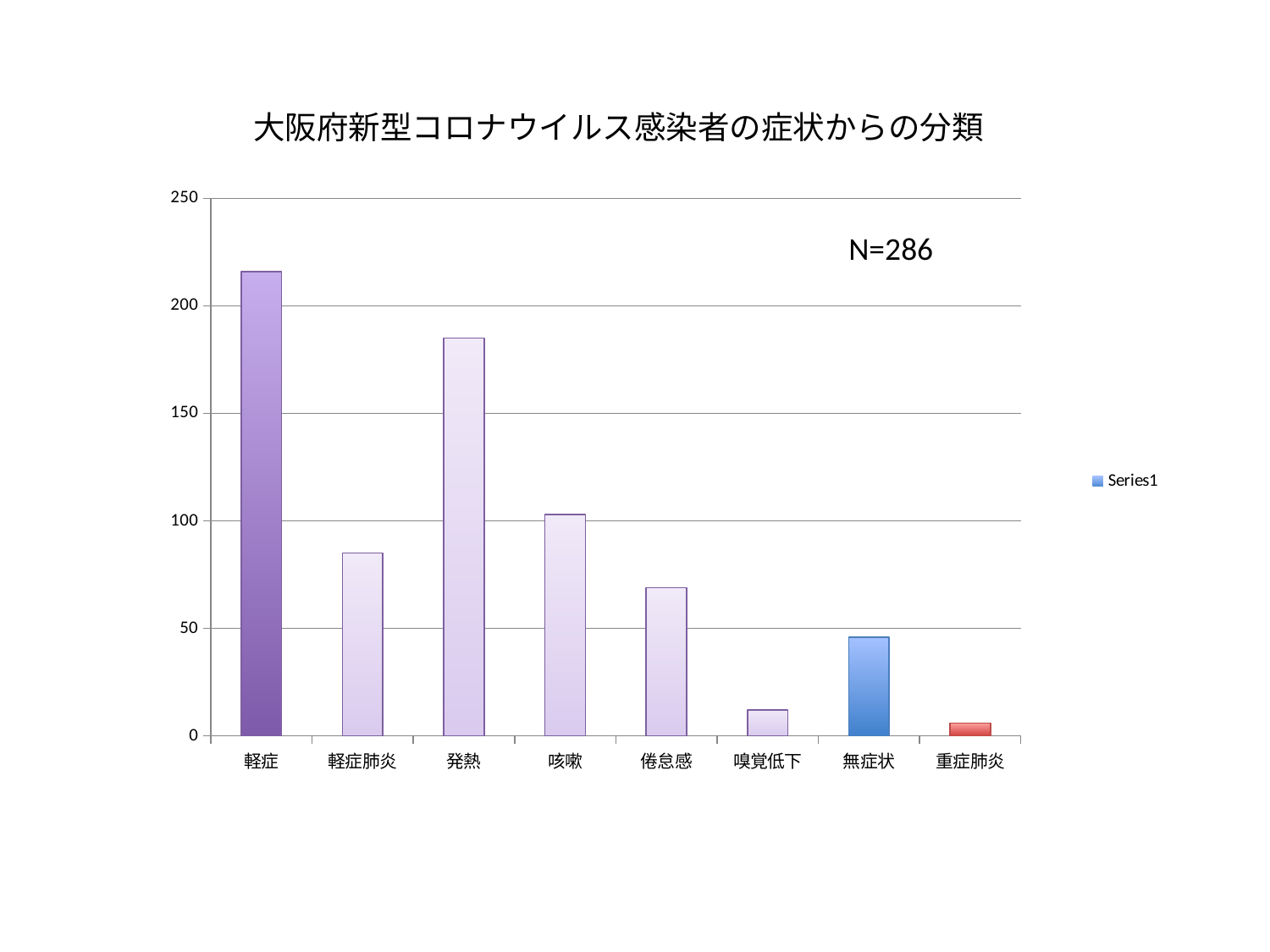
What is the title of the chart? 大阪府新型コロナウイルス感染者の症状からの分類 How many categories are shown on the x axis of the chart? 8 Is the value for 倦怠感 greater or less than 50? greater Which category has the highest value? 軽症 How many series does the legend list? 1 Is the value for 軽症 greater or less than 200? greater What kind of chart is shown on the slide? bar chart Is the value for 嗅覚低下 greater or less than 50? less Which is larger, the value for 軽症肺炎 or the value for 倦怠感? 軽症肺炎 Which is larger, the value for 発熱 or the value for 咳嗽? 発熱 Which category has the lowest value? 重症肺炎